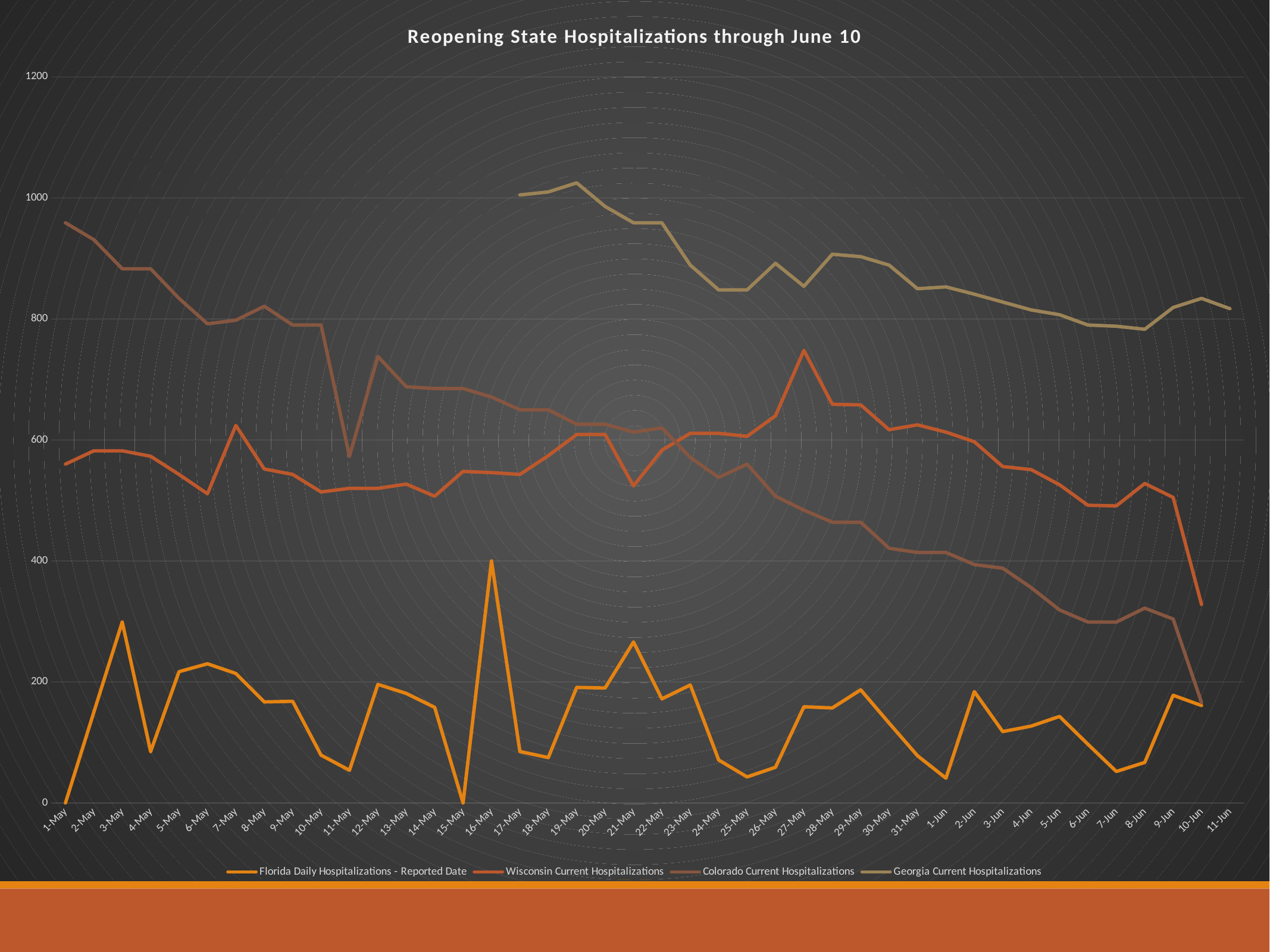
Do the values for Colorado Current Hospitalizations generally rise or fall from 1-May to 10-Jun? fall Is the value for Colorado Current Hospitalizations on 10-Jun greater or less than 200? less How many series does the legend list? 4 What kind of chart is shown on the slide? line chart Which series is drawn with the bright orange line? Florida Daily Hospitalizations - Reported Date Which series has the highest value on 20-May? Georgia Current Hospitalizations Is the value for Georgia Current Hospitalizations on 19-May greater or less than 1000? greater On 1-Jun, which is larger: Georgia Current Hospitalizations or Wisconsin Current Hospitalizations? Georgia Current Hospitalizations What is the value for Florida Daily Hospitalizations - Reported Date on 1-May? 0 What is the title of the chart? Reopening State Hospitalizations through June 10 Is the value for Wisconsin Current Hospitalizations on 27-May greater or less than 600? greater